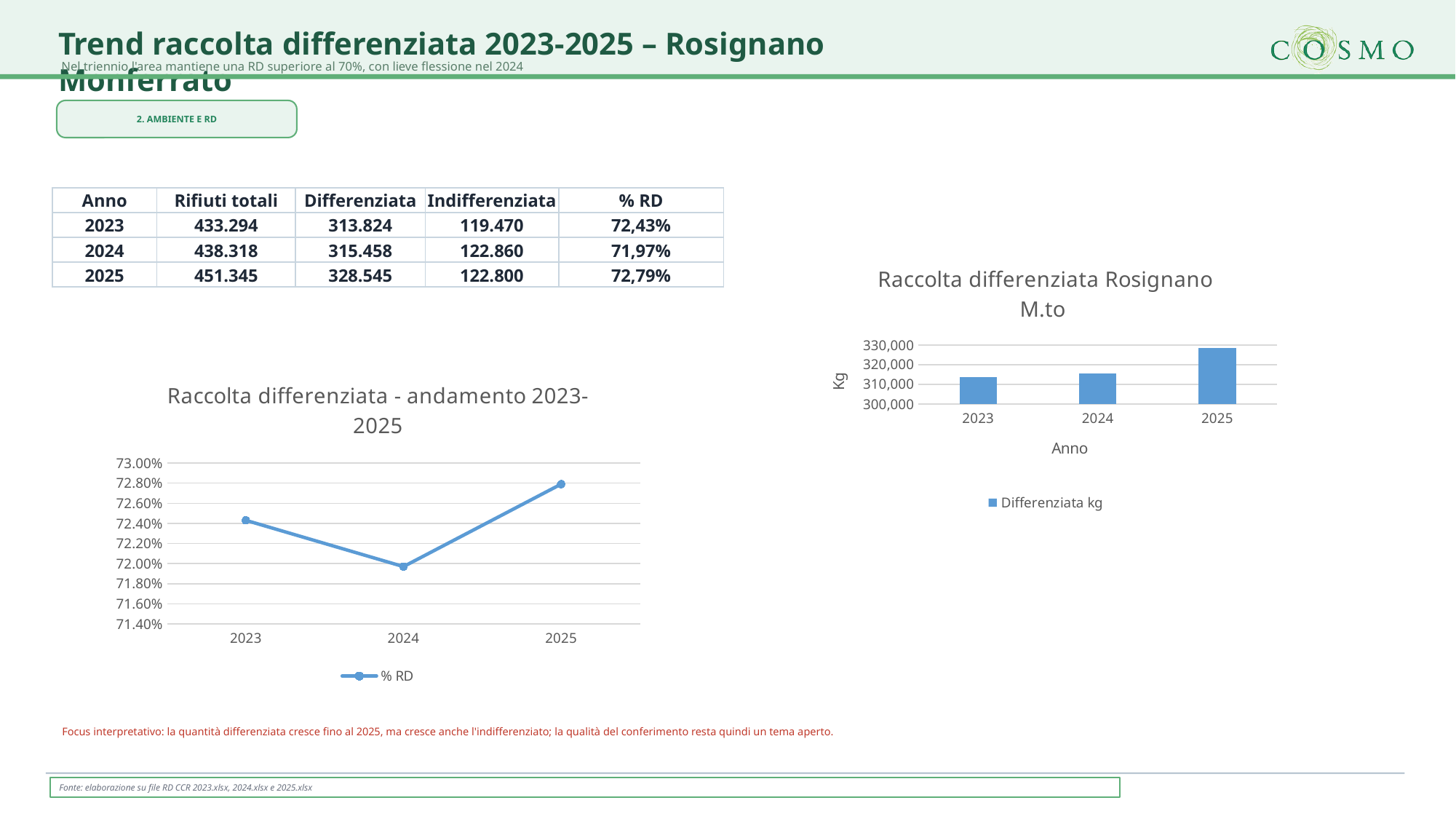
In the chart "Raccolta differenziata - andamento 2023-2025", how many data points are plotted? 3 In the chart "Raccolta differenziata - andamento 2023-2025", which year has the lowest % RD? 2024 In the chart "Raccolta differenziata - andamento 2023-2025", is the value for 2024 greater or less than 72.20%? less In the chart "Raccolta differenziata Rosignano M.to", do the bar values rise or fall from 2023 to 2025? rise What kind of chart is "Raccolta differenziata Rosignano M.to"? bar chart In the chart "Raccolta differenziata Rosignano M.to", is the value for 2024 greater or less than 320,000? less What is the legend entry of the chart "Raccolta differenziata Rosignano M.to"? Differenziata kg In the chart "Raccolta differenziata Rosignano M.to", which year has the tallest bar? 2025 In the chart "Raccolta differenziata - andamento 2023-2025", is the value for 2025 greater or less than 72.60%? greater What kind of chart is "Raccolta differenziata - andamento 2023-2025"? line chart In the chart "Raccolta differenziata - andamento 2023-2025", which year has the highest % RD? 2025